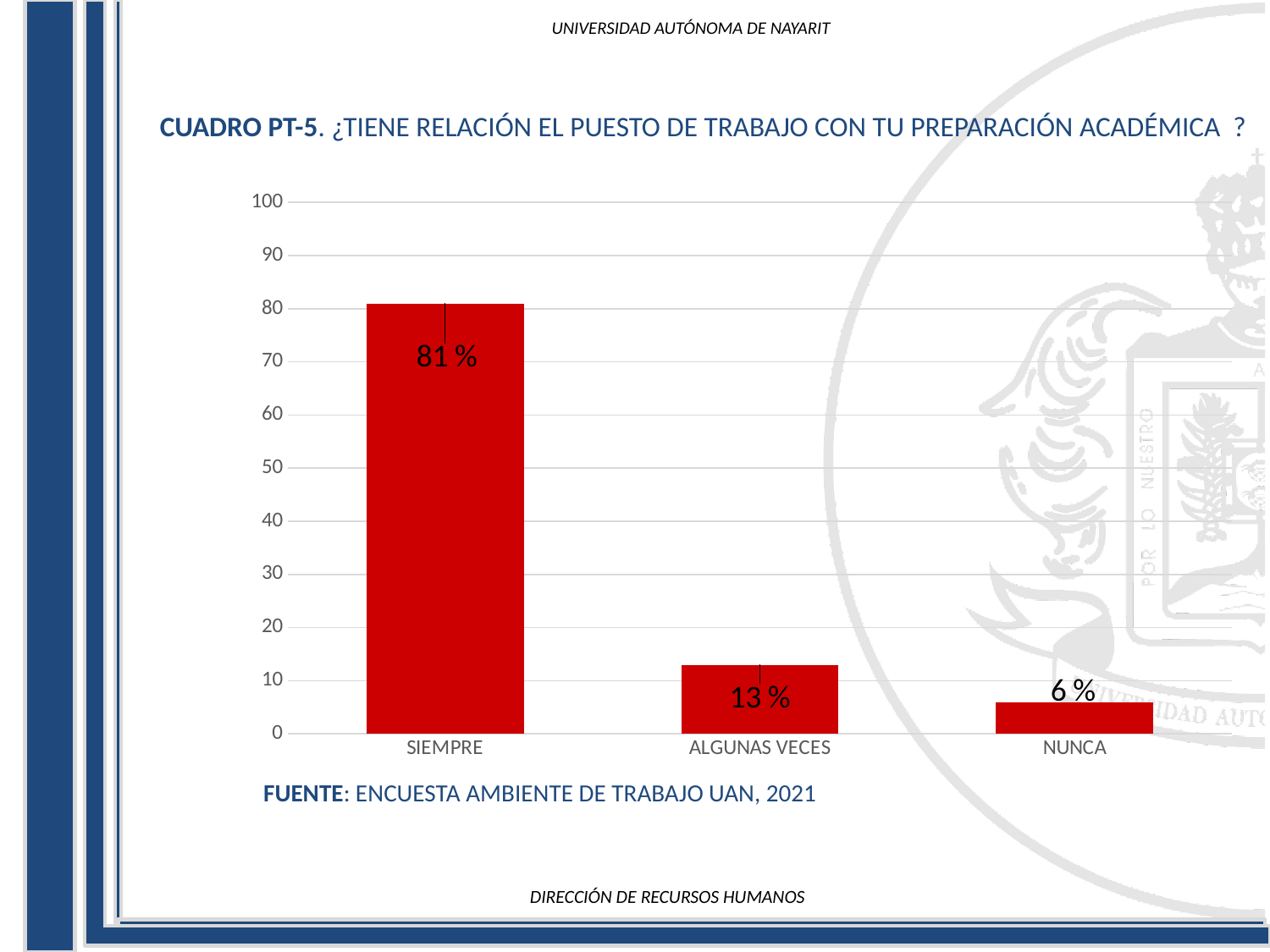
What is the value for SIEMPRE? 81 % What kind of chart is shown on the slide? bar chart Which category has the lowest value? NUNCA What is the source cited below the chart? ENCUESTA AMBIENTE DE TRABAJO UAN, 2021 What is the value for ALGUNAS VECES? 13 % Which category has the highest value? SIEMPRE How many categories are shown on the x axis? 3 Which is larger, the value for ALGUNAS VECES or the value for NUNCA? ALGUNAS VECES What is the difference between the values for SIEMPRE and ALGUNAS VECES? 68 % What is the value for NUNCA? 6 % Is the value for SIEMPRE greater or less than 50? greater What is the difference between the values for ALGUNAS VECES and NUNCA? 7 %